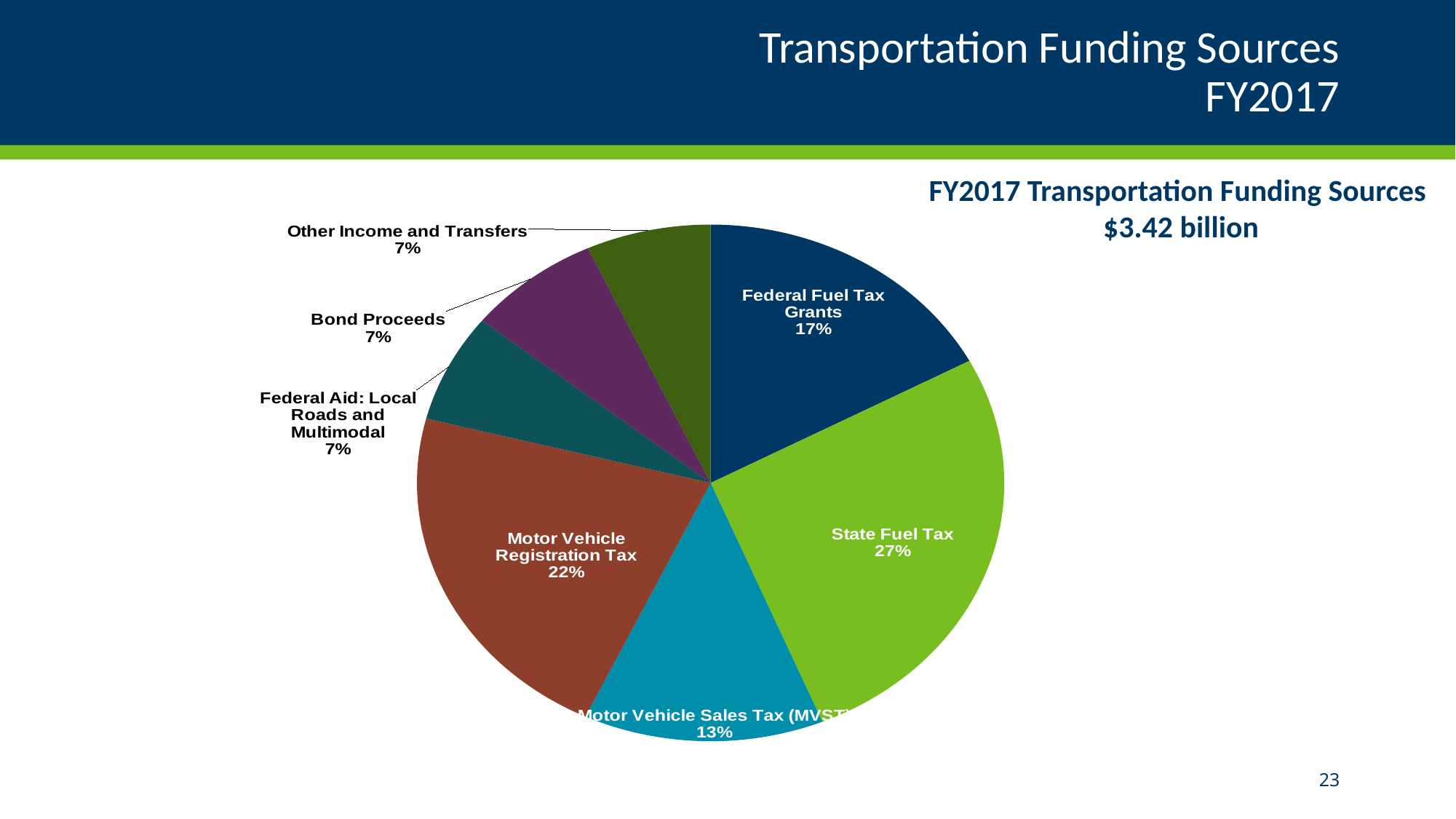
What kind of chart is shown on the slide? pie chart What is the difference in percentage points between State Fuel Tax and Motor Vehicle Registration Tax? 5% How many slices does the pie chart have? 7 Which funding source has the largest share of the pie? State Fuel Tax Which is larger, Federal Fuel Tax Grants or Motor Vehicle Sales Tax (MVST)? Federal Fuel Tax Grants What colour is the State Fuel Tax slice? green What total dollar amount is stated for FY2017 Transportation Funding Sources? $3.42 billion What share of funding comes from Federal Fuel Tax Grants? 17% What share of FY2017 transportation funding comes from State Fuel Tax? 27% What share of funding comes from Motor Vehicle Sales Tax (MVST)? 13%